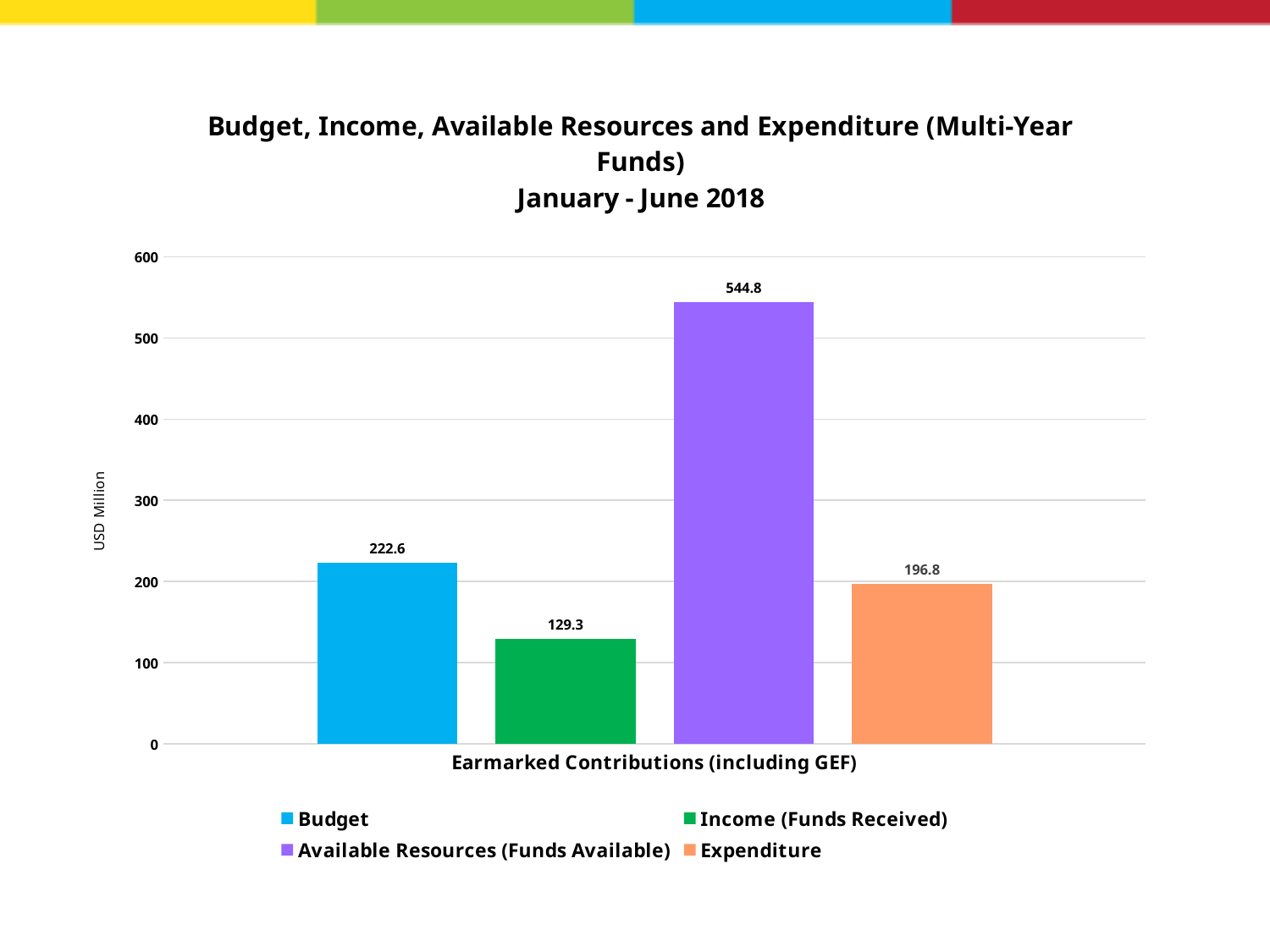
What is the value for Income (Funds Received)? 129.3 Which series has the lowest value? Income (Funds Received) What is the value for Budget? 222.6 What is the difference between Available Resources (Funds Available) and Expenditure? 348.0 What kind of chart is shown? Bar chart How many series does the legend list? 4 Which is larger, Budget or Expenditure? Budget Which series has the highest value? Available Resources (Funds Available) What is the label on the vertical axis? USD Million What is the value for Available Resources (Funds Available)? 544.8 What is the difference between Budget and Income (Funds Received)? 93.3 What is the value for Expenditure? 196.8